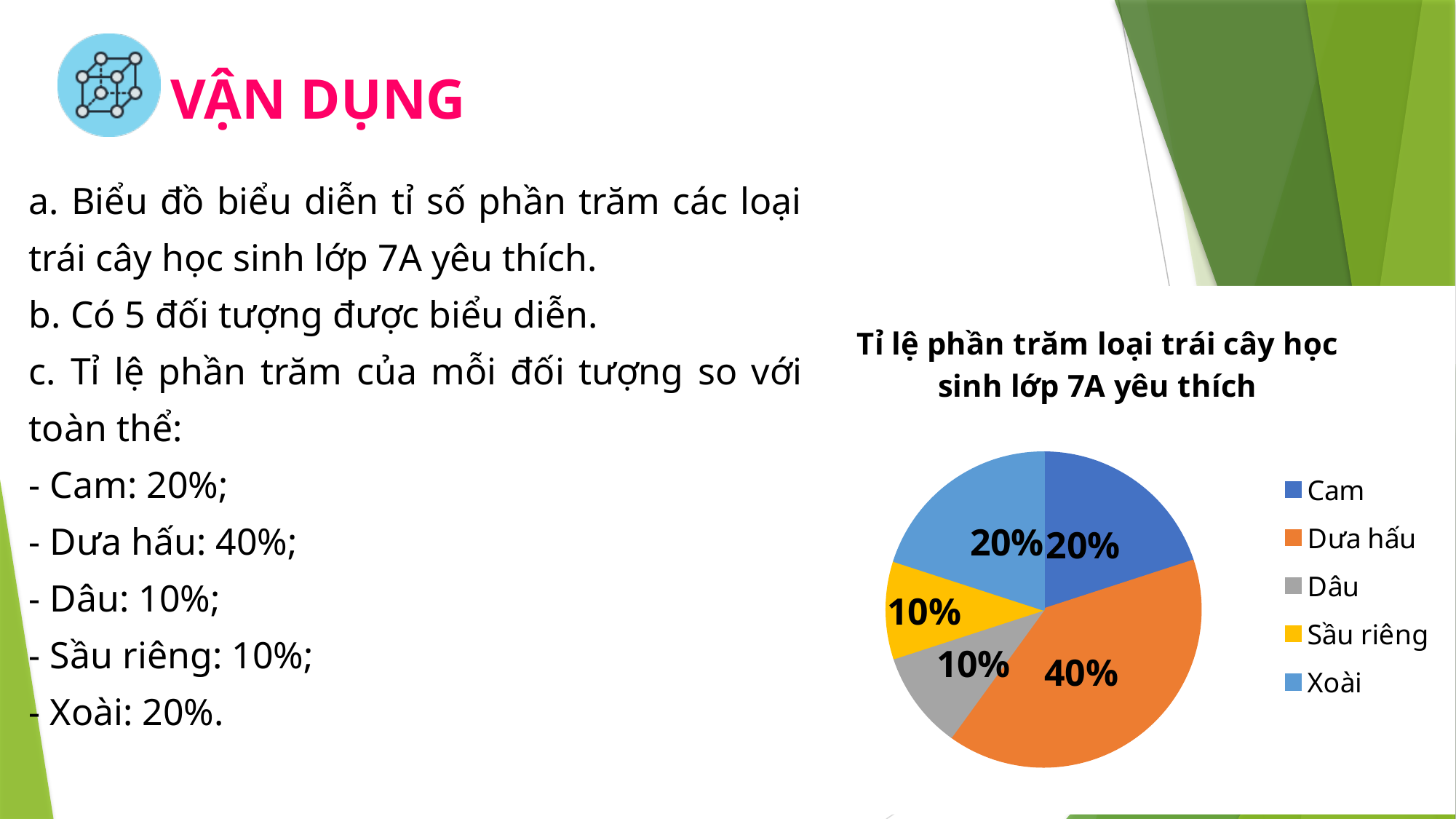
What percentage of the pie chart is Xoài? 20% What is the difference between the Dưa hấu slice and the Dâu slice? 30% What percentage of the pie chart is Dâu? 10% What percentage of the pie chart is Cam? 20% What is the title of the pie chart? Tỉ lệ phần trăm loại trái cây học sinh lớp 7A yêu thích Which fruit has the largest slice in the pie chart? Dưa hấu What kind of chart is shown on the slide? pie chart How many categories does the pie chart show? 5 What percentage of the pie chart is Dưa hấu? 40% Which colour represents Xoài in the pie chart? light blue What percentage of the pie chart is Sầu riêng? 10% Which is larger in the pie chart, Cam or Sầu riêng? Cam